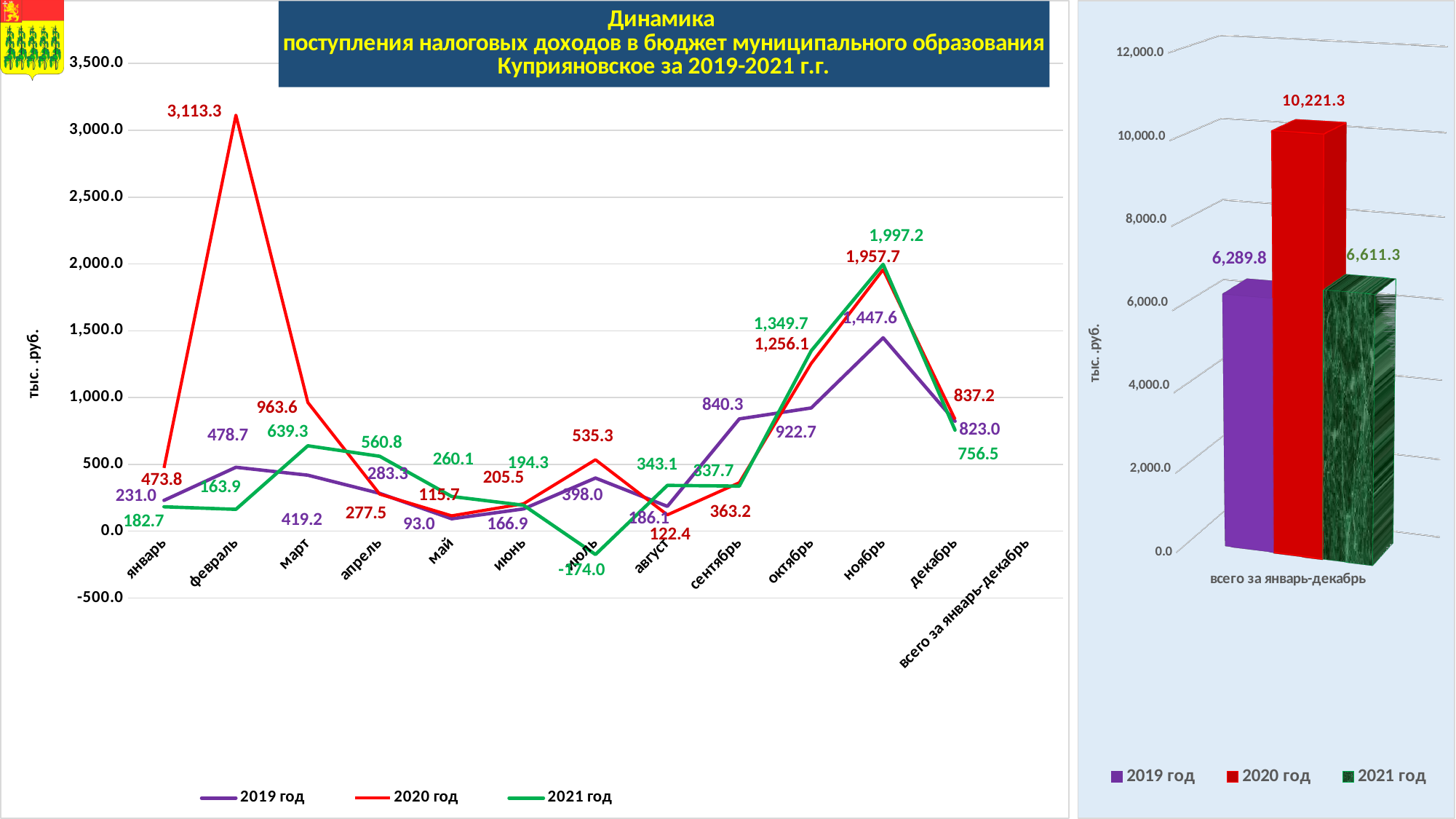
On the line chart, in which month does the 2020 год series reach its highest value? февраль On the line chart, what is the value for ноябрь in the 2021 год series? 1,997.2 What kind of chart is the chart on the right side of the slide? bar chart On the right bar chart, what is the difference between the 2021 год and 2019 год values? 321.5 On the line chart, what is the value for июль in the 2021 год series? -174.0 On the line chart, what is the difference between the 2021 год and 2020 год values for ноябрь? 39.5 On the line chart, what is the value for февраль in the 2020 год series? 3,113.3 On the right bar chart, which year has the lowest total for январь-декабрь? 2019 год On the line chart, in which month does the 2019 год series have its lowest value? май How many series does the legend of the line chart list? 3 On the right bar chart, what is the value for 2020 год? 10,221.3 On the line chart, which series has the larger value for сентябрь: 2019 год or 2020 год? 2019 год